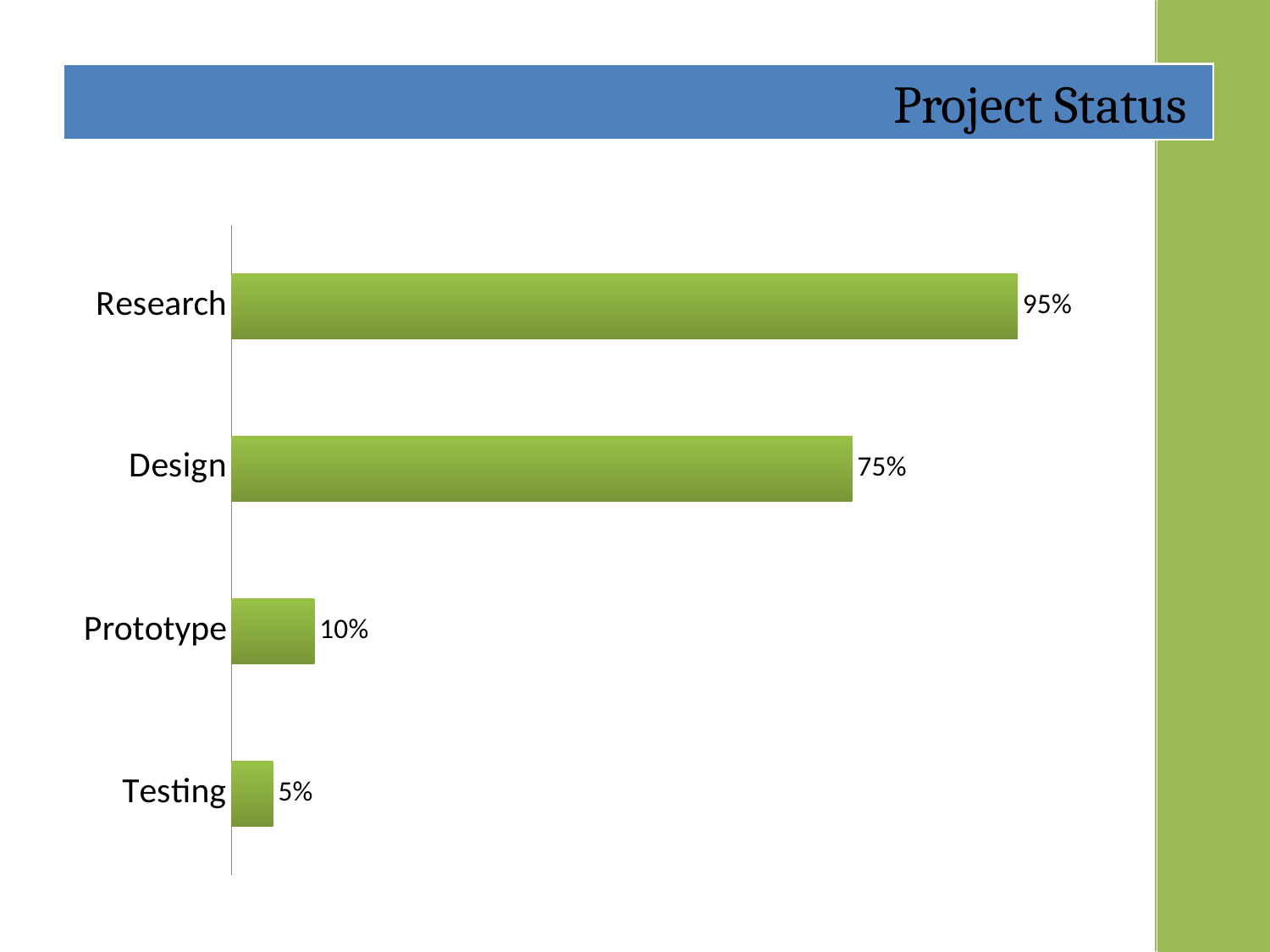
Which category has the lowest value? Testing What is the value for Design? 75% What is the value for Research? 95% Which is larger, the value for Design or the value for Prototype? Design What is the difference between the values for Research and Design? 20% What kind of chart is shown on the slide? Bar chart What is the value for Prototype? 10% How many categories are shown in the chart? 4 What is the difference between the values for Prototype and Testing? 5% What is the value for Testing? 5% Which category has the highest value? Research What is the title of the slide containing the chart? Project Status